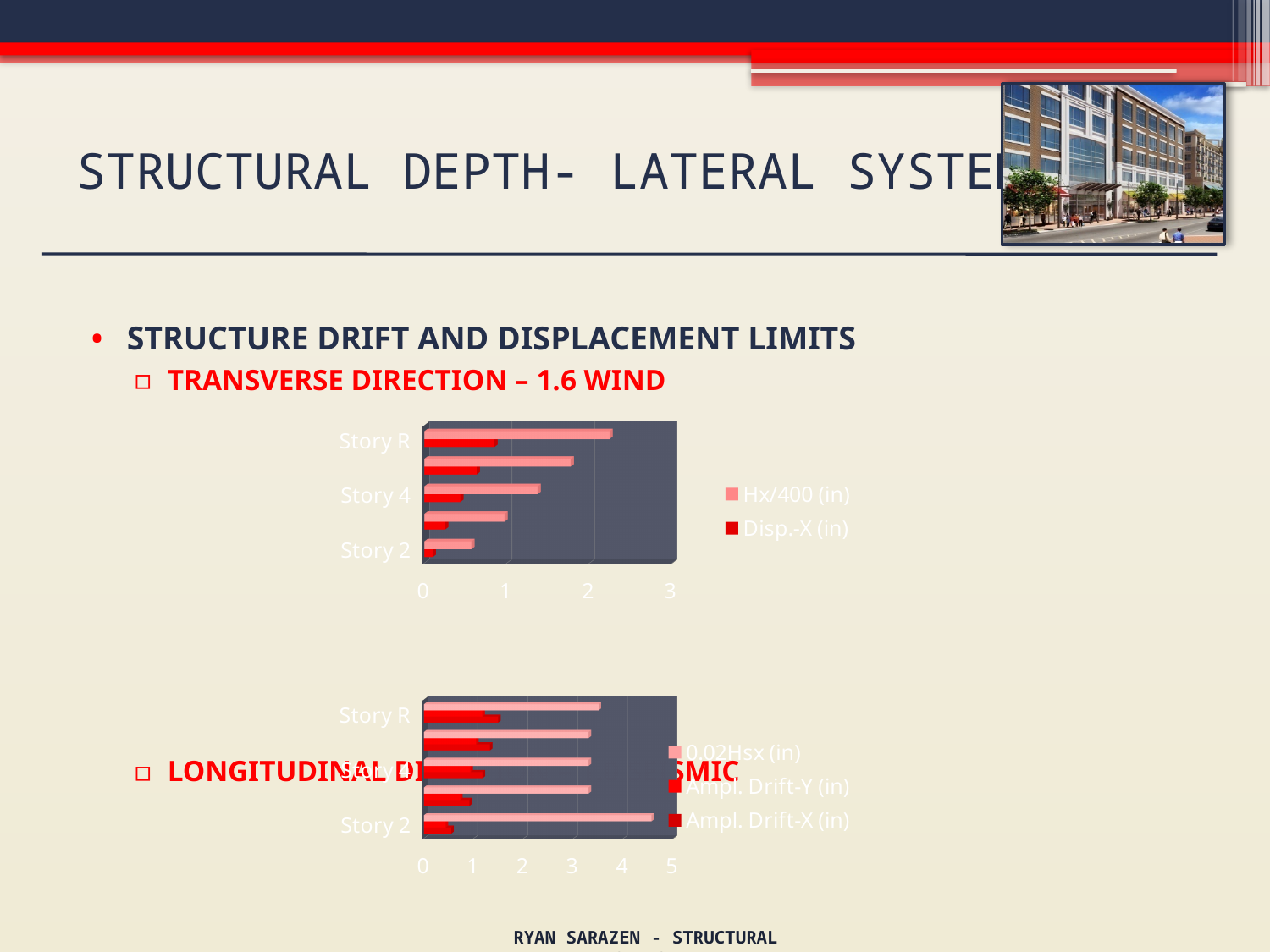
How many series does the legend of the top chart list? 2 In the bottom chart, which story has the larger 0.02Hsx (in) value, Story R or Story 2? Story 2 What is the highest value shown on the horizontal axis of the top chart? 3 In the top chart, what are the two legend entries? Hx/400 (in) and Disp.-X (in) In the top chart, do the Hx/400 (in) values increase or decrease going from Story R down to Story 2? decrease In the top chart, is the Hx/400 (in) value for Story R greater or less than 2? greater In the bottom chart, is the 0.02Hsx (in) value for Story 2 greater or less than 4? greater What type of chart is the top chart under 'Transverse Direction – 1.6 Wind'? bar chart How many series does the legend of the bottom chart list? 3 In the bottom chart, is the 0.02Hsx (in) value for Story R greater or less than 3? greater In the top chart, which series has the larger value at Story R, Hx/400 (in) or Disp.-X (in)? Hx/400 (in)